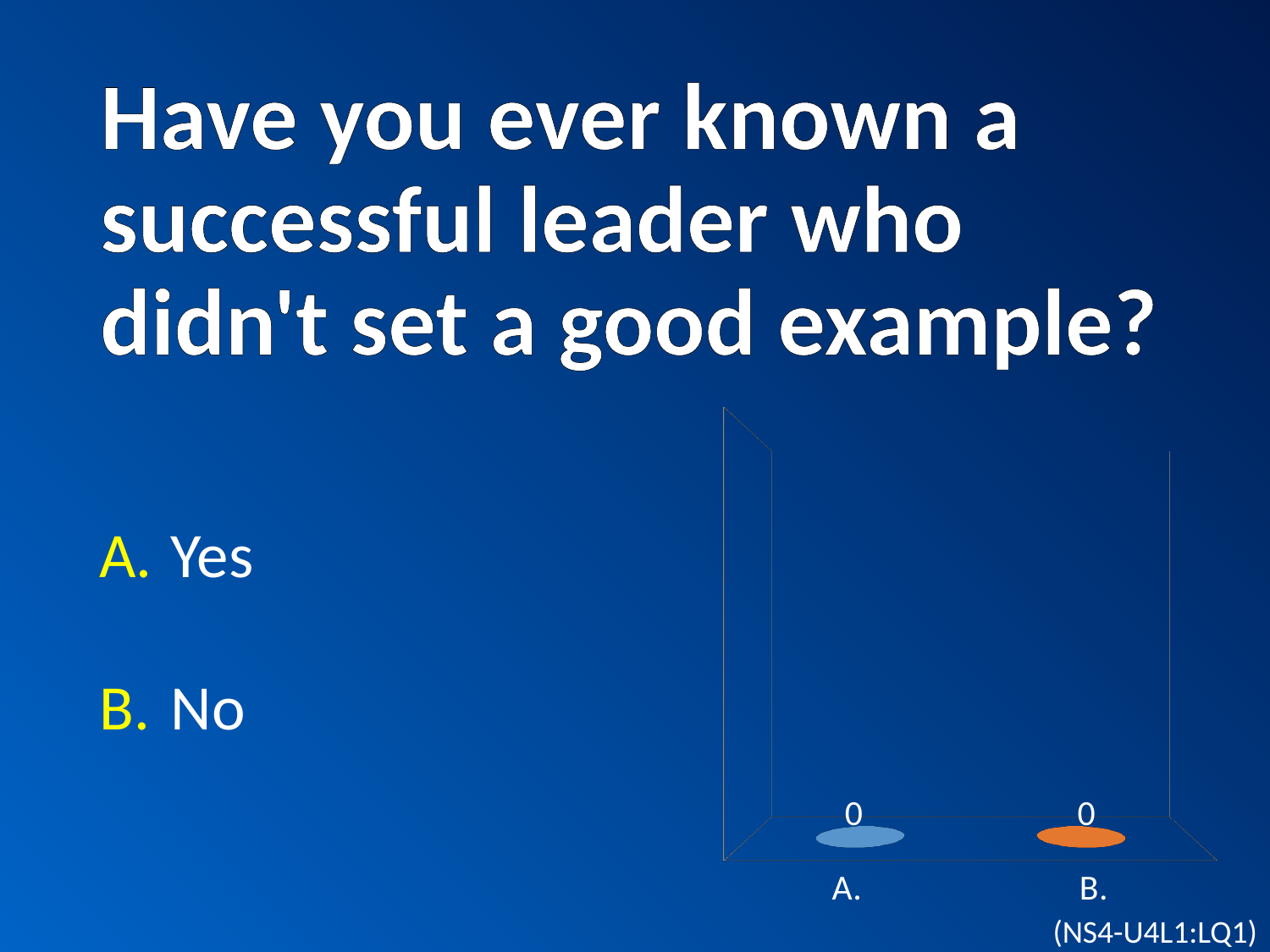
How many categories are plotted in the chart? 2 What kind of chart is shown on the slide? bar chart What colour is the bar for category B.? orange What is the value shown for category A. in the chart? 0 What is the value shown for category B. in the chart? 0 Are the values for A. and B. equal or different? equal What are the category labels on the x axis of the chart? A. and B. What is the difference between the values for A. and B.? 0